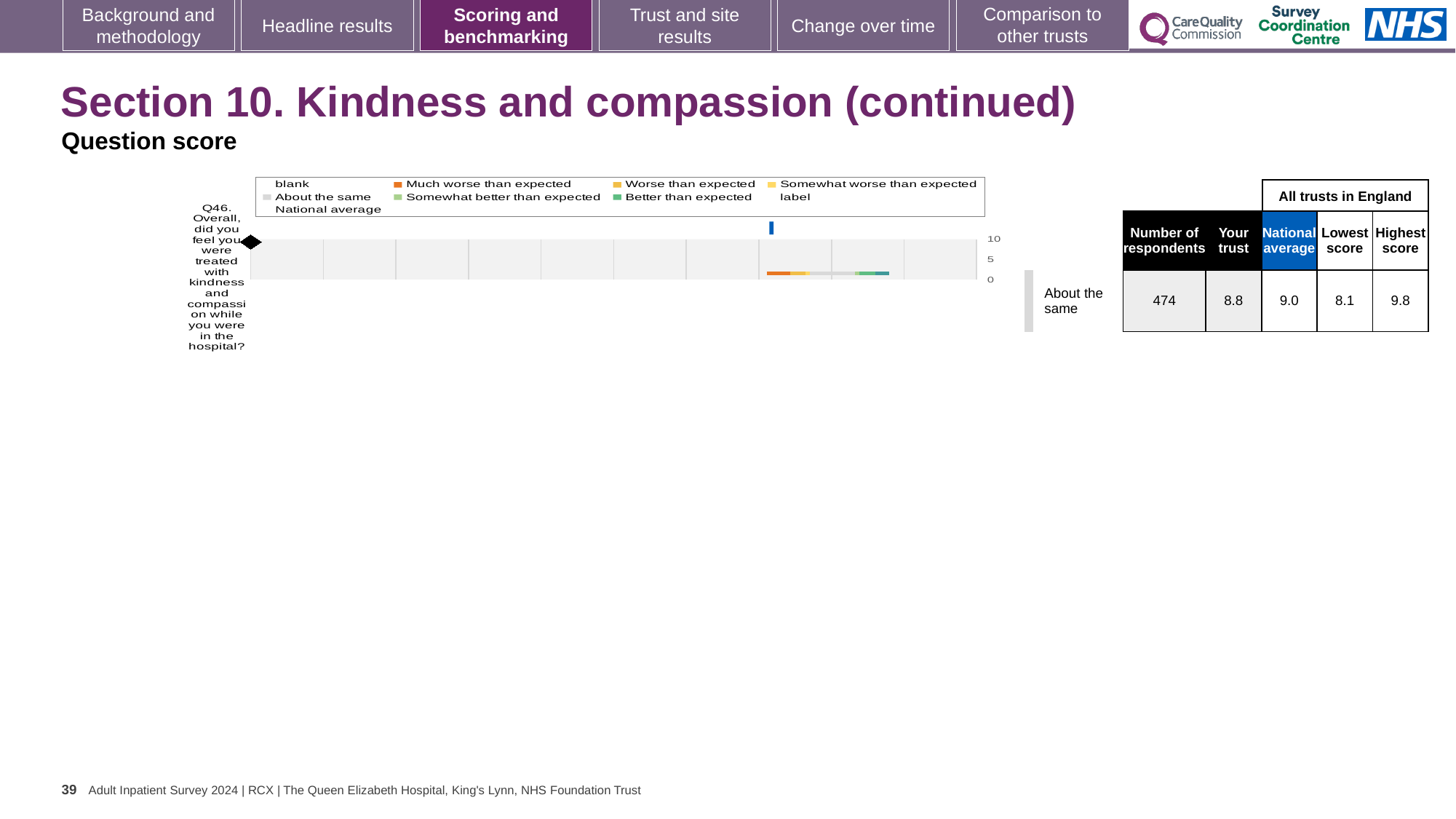
According to the table next to the chart, what is the Highest score among all trusts in England for Q46? 9.8 How many respondents are listed for Q46 in the table next to the chart? 474 According to the table next to the chart, what is the National average score for Q46? 9.0 What kind of chart is shown on the slide? bar chart Which is larger for Q46, the Your trust score or the National average score? National average What benchmarking category is the trust's Q46 score placed in, as labelled beside the chart? About the same What is the highest value shown on the chart's axis? 10 Which question number is plotted on the chart? Q46 How many questions (categories) are plotted on the chart? 1 According to the table next to the chart, what is the Lowest score among all trusts in England for Q46? 8.1 What is the difference between the Highest score and the Lowest score for Q46 in the table? 1.7 According to the table next to the chart, what is the score for Your trust for Q46? 8.8